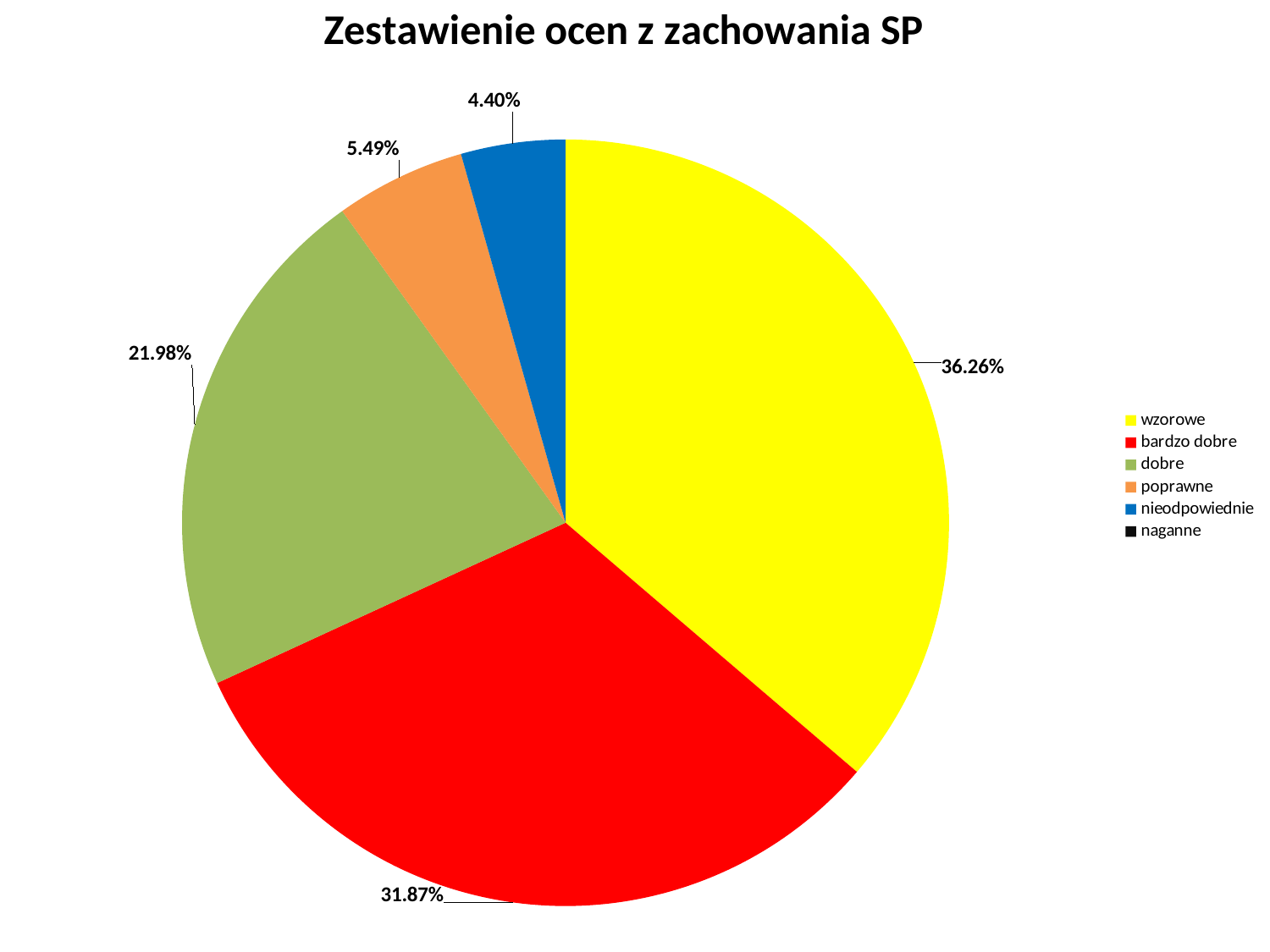
What type of chart is shown on the slide? pie chart What percentage share does the 'poprawne' slice have? 5.49% Which category has the largest slice of the pie? wzorowe What colour is the 'bardzo dobre' slice? red How many categories does the legend list? 6 What percentage share does the 'bardzo dobre' slice have? 31.87% What percentage share does the 'wzorowe' slice have? 36.26% What is the title of the chart? Zestawienie ocen z zachowania SP What percentage share does the 'dobre' slice have? 21.98% What is the difference in percentage points between the 'wzorowe' and 'bardzo dobre' slices? 4.39 Which slice is larger, 'dobre' or 'poprawne'? dobre What percentage share does the 'nieodpowiednie' slice have? 4.40%